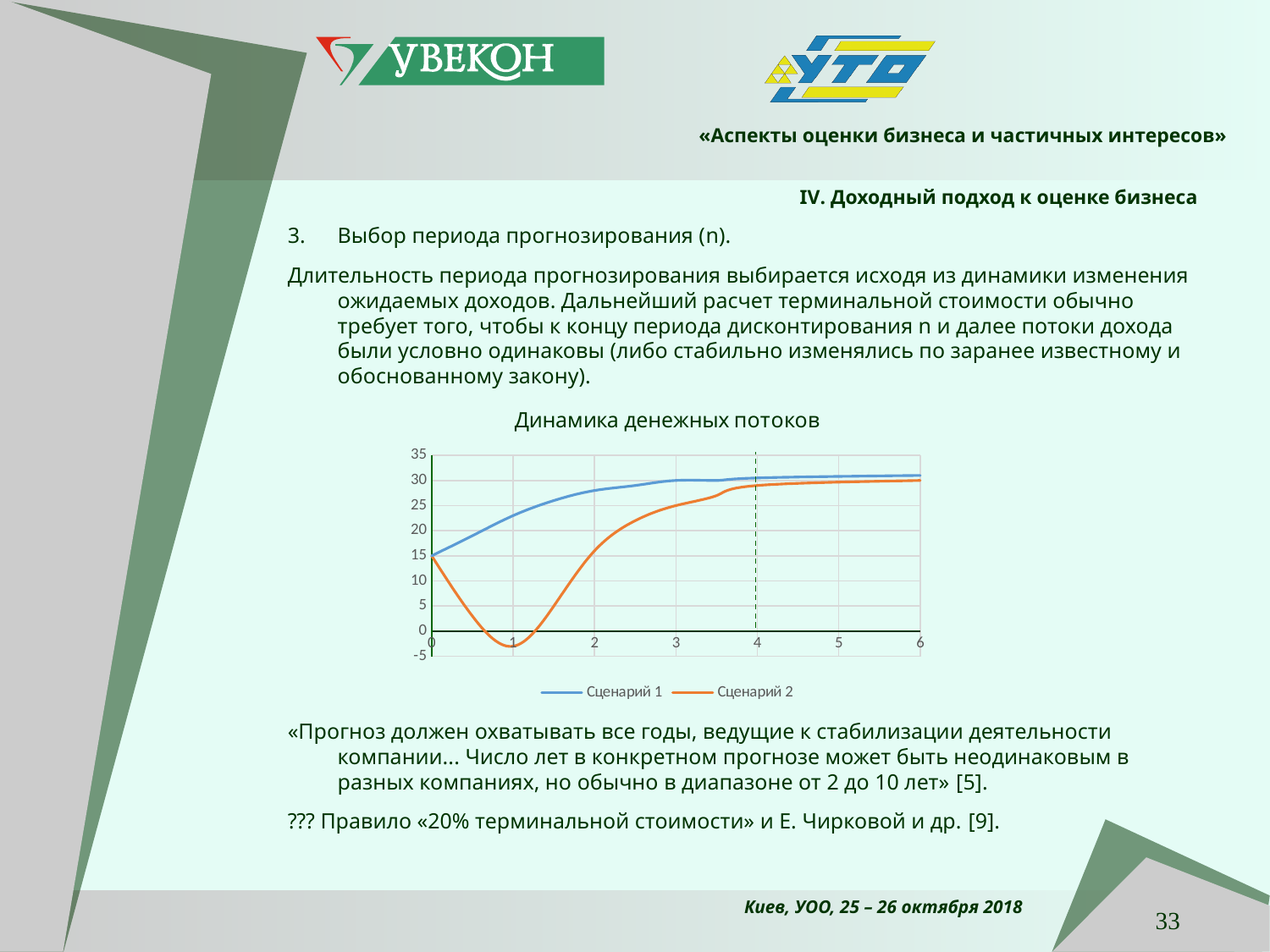
Is the value of Сценарий 1 at x = 2 greater or less than 25? greater Is the value of Сценарий 2 at x = 4 greater or less than 25? greater What is the title of the chart? Динамика денежных потоков What kind of chart is shown on the slide? line chart Is the value of Сценарий 2 at x = 1 greater or less than 0? less At x = 2, which series has the higher value, Сценарий 1 or Сценарий 2? Сценарий 1 Does the line for Сценарий 1 rise or fall as x increases from 0 to 6? rises Which series is drawn in orange in the chart? Сценарий 2 How many series does the legend of the chart list? 2 Does the line for Сценарий 2 first fall or rise after x = 0? falls At which x value is the dashed vertical line drawn in the chart? 4